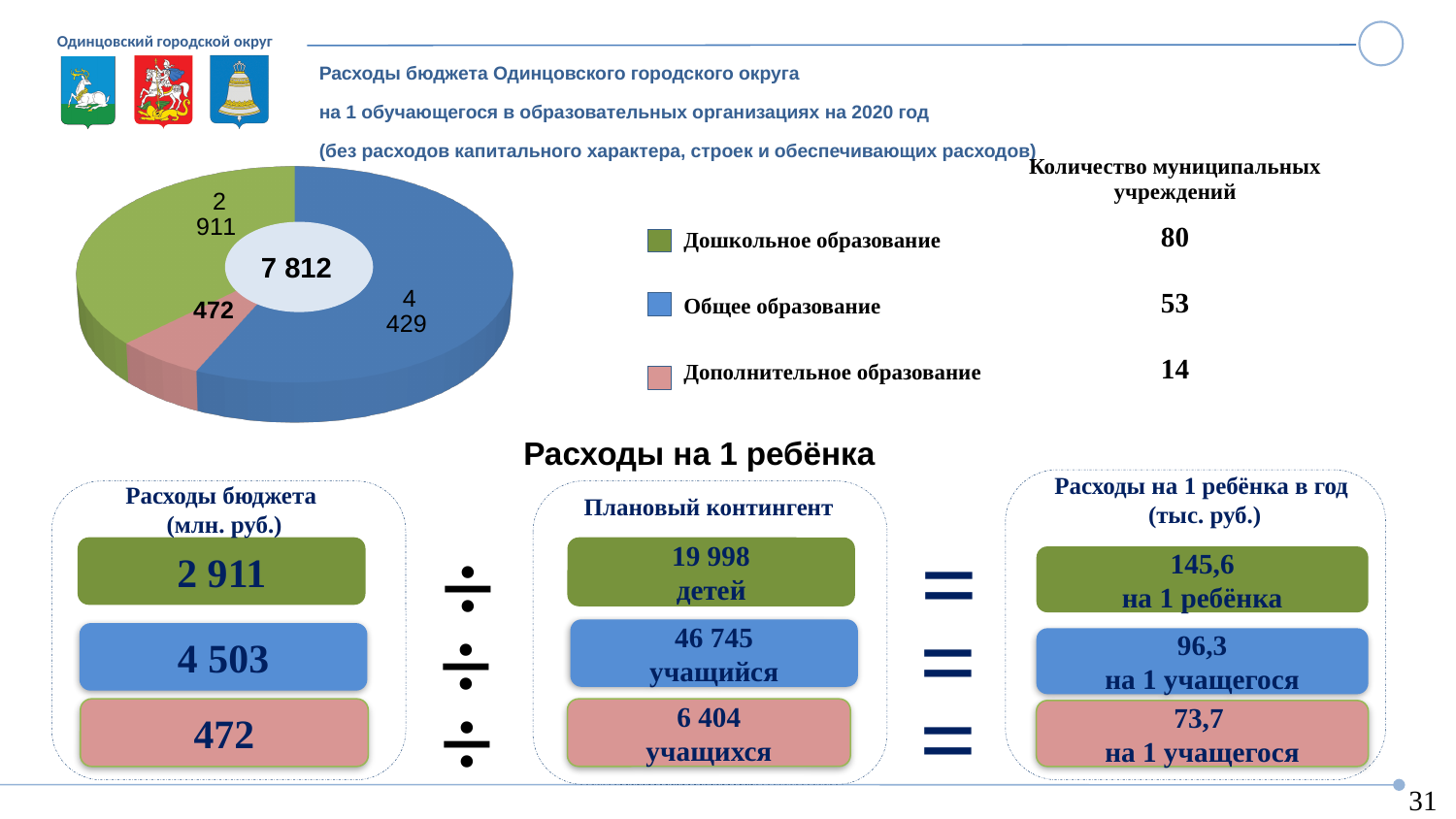
How many slices does the pie chart have? 3 Which category has the smallest slice in the pie chart? Дополнительное образование In the pie chart, what is the difference between the values for Общее образование and Дошкольное образование? 1 518 In the pie chart, what is the value for Дошкольное образование? 2 911 Which category does the green slice of the pie chart represent? Дошкольное образование Which category has the largest slice in the pie chart? Общее образование What colour is the slice for Дополнительное образование in the pie chart? pink In the pie chart, what is the value for Общее образование? 4 429 In the pie chart, what is the value for Дополнительное образование? 472 What type of chart is shown at the top left of the slide? pie chart What total value is shown in the centre of the pie chart? 7 812 In the pie chart, which is larger: Дошкольное образование or Дополнительное образование? Дошкольное образование